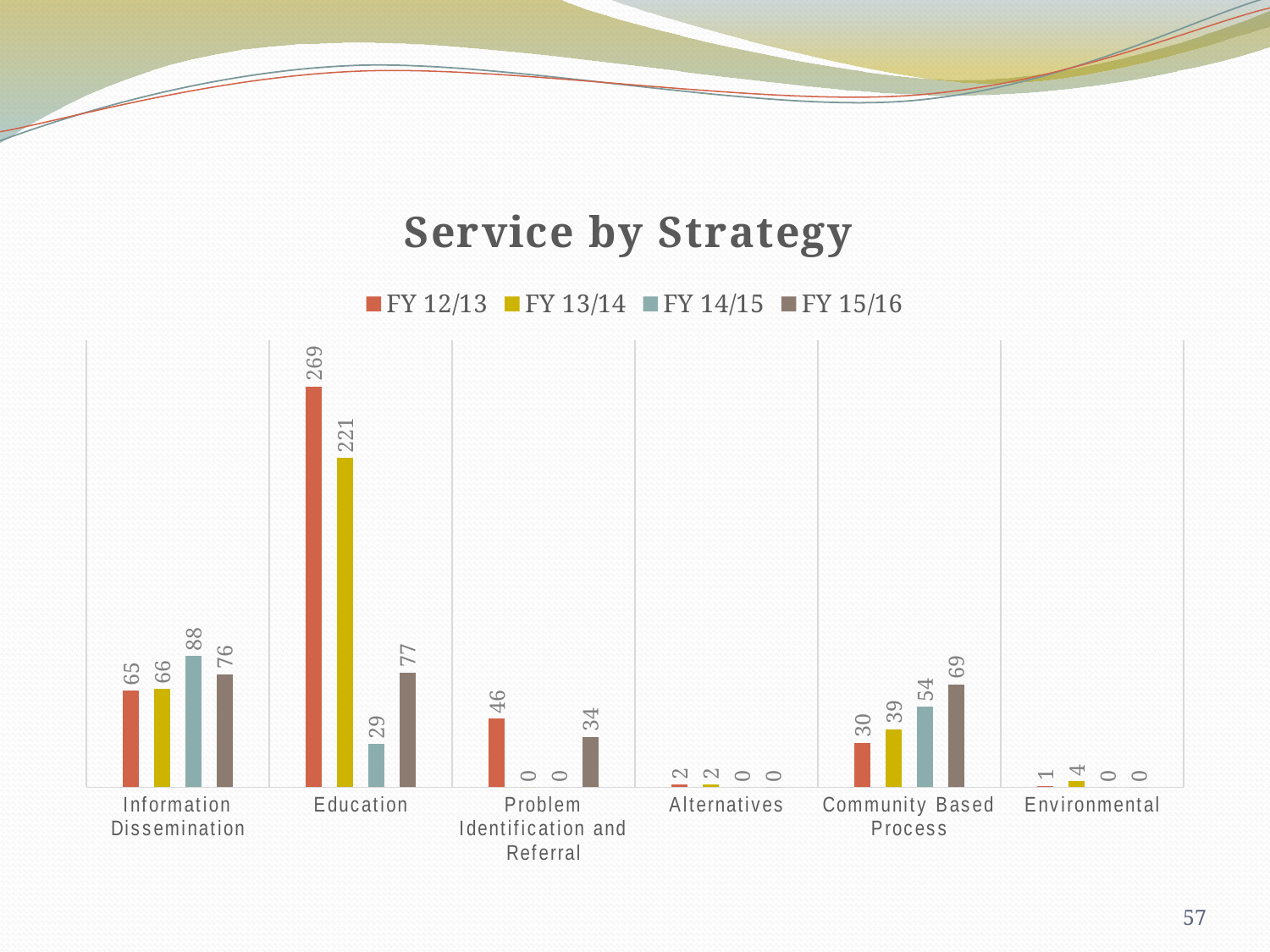
How many series does the legend list? 4 What kind of chart is shown on the slide? Bar chart What is the difference between the FY 12/13 and FY 13/14 values for Education? 48 What is the value for Education in FY 12/13? 269 How many categories are shown on the x axis? 6 Which category has the lowest value in FY 12/13? Environmental Do the values for Community Based Process rise or fall from FY 12/13 to FY 15/16? Rise What is the value for Community Based Process in FY 15/16? 69 Which is larger for Community Based Process: the FY 14/15 value or the FY 13/14 value? FY 14/15 Which category has the highest value in FY 13/14? Education What is the value for Information Dissemination in FY 14/15? 88 What is the title of the chart? Service by Strategy